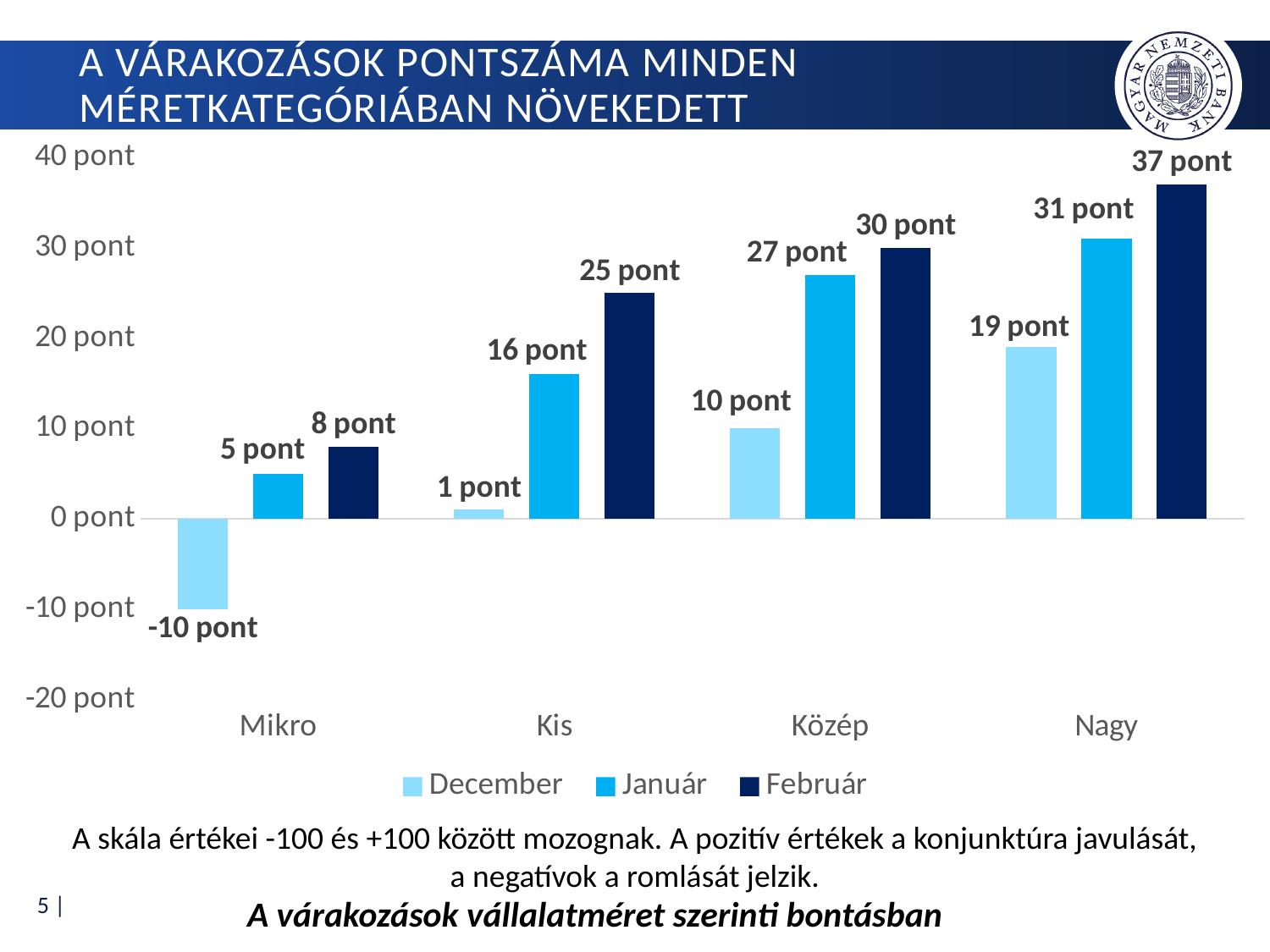
What kind of chart is shown on the slide? bar chart Do the Február values rise or fall from Mikro to Nagy? rise Which category has the lowest value in December? Mikro What is the difference between the Február and December values for Közép? 20 pont What is the value for Mikro in December? -10 pont Which category has the highest value in Február? Nagy How many series does the legend list? 3 What is the value for Közép in Január? 27 pont How many categories are shown on the x axis? 4 What is the value for Kis in December? 1 pont Which is larger: the Január value for Kis or the Január value for Közép? Közép What is the value for Nagy in Február? 37 pont